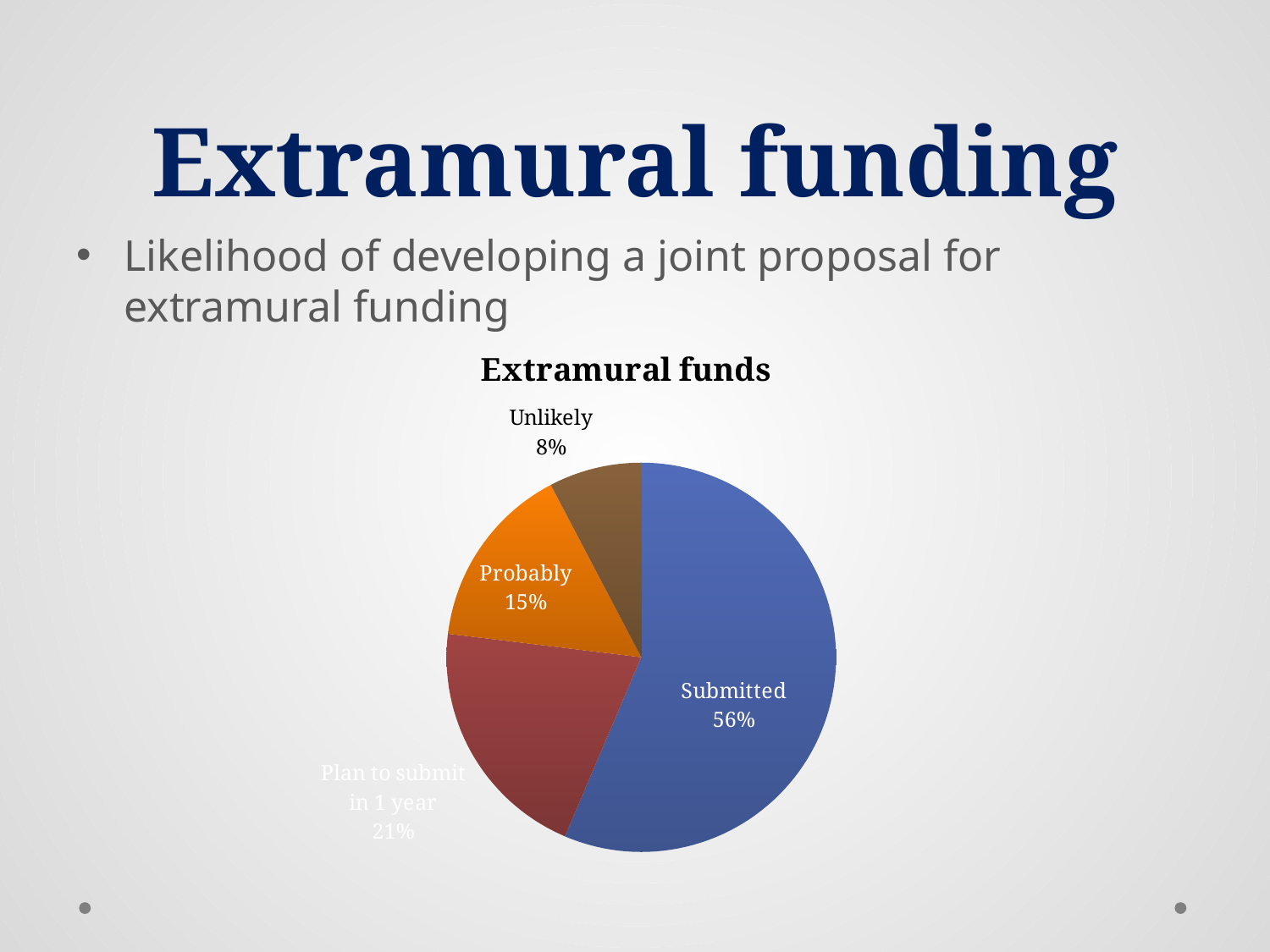
Which is larger, the share for Probably or the share for Plan to submit in 1 year? Plan to submit in 1 year What type of chart is shown on the slide? pie chart What percentage of the pie is labelled Probably? 15% How many slices does the pie chart have? 4 What is the title of the chart? Extramural funds What colour is the Submitted slice? blue What is the difference in percentage points between the Submitted and Probably slices? 41 Which category has the largest share of the pie? Submitted What percentage of the pie is labelled Plan to submit in 1 year? 21% Which category has the smallest share of the pie? Unlikely What percentage of the pie is labelled Submitted? 56% What percentage of the pie is labelled Unlikely? 8%